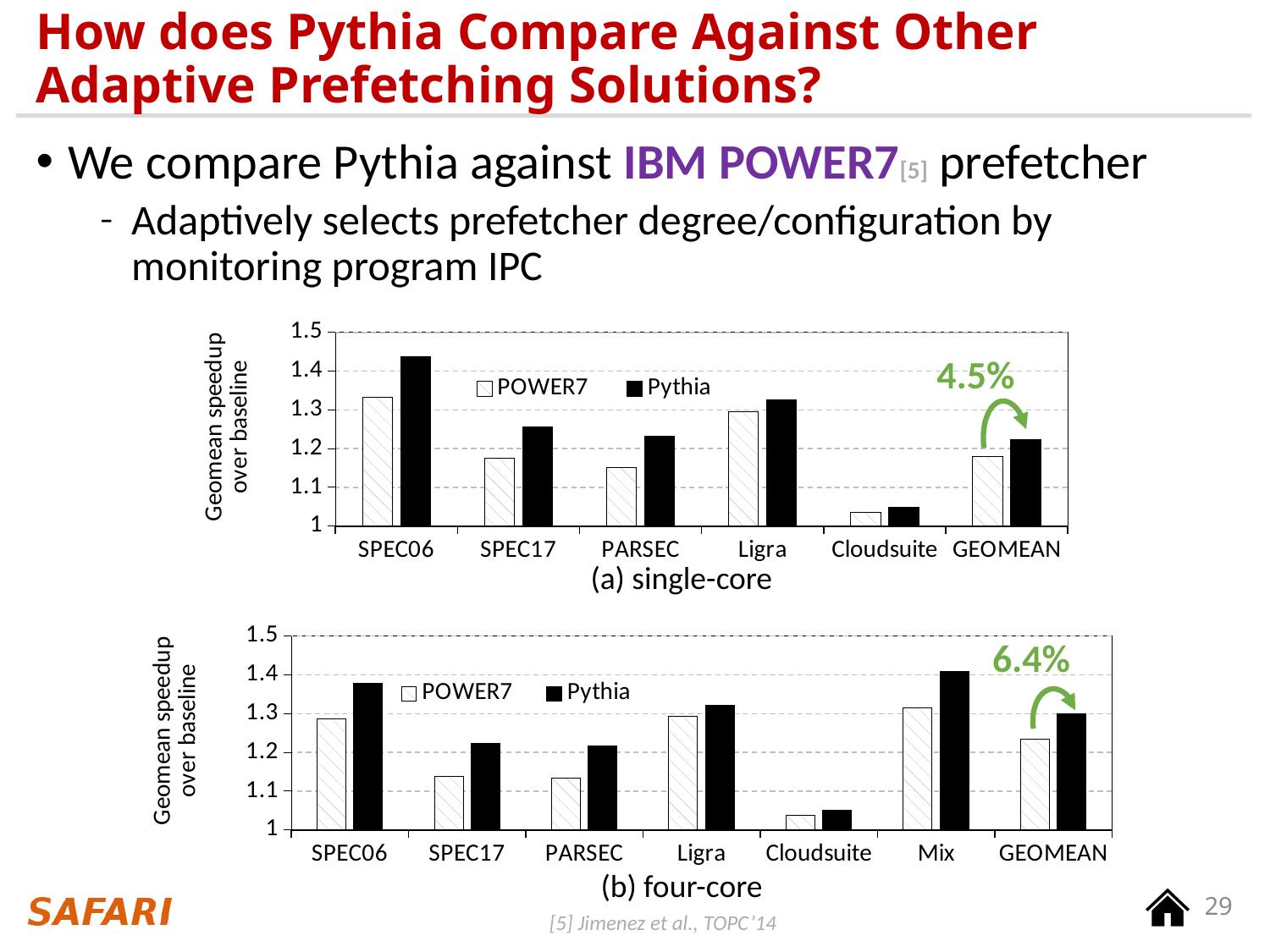
In chart (b) four-core, which category has the highest Pythia bar? Mix In chart (a) single-core, which category has the lowest POWER7 bar? Cloudsuite In chart (a) single-core, is the Pythia value for SPEC06 greater or less than 1.4? greater In chart (a) single-core, is the POWER7 value for PARSEC greater or less than 1.2? less In chart (b) four-core, how many benchmark categories are shown on the x axis? 7 In chart (a) single-core, how many benchmark categories are shown on the x axis? 6 What percentage improvement is annotated above the GEOMEAN bars in chart (b) four-core? 6.4% In chart (b) four-core, which is larger for Ligra: the POWER7 bar or the Pythia bar? Pythia What kind of chart is chart (b) four-core? bar chart In chart (a) single-core, which category has the highest Pythia bar? SPEC06 In chart (a) single-core, how many series does the legend list? 2